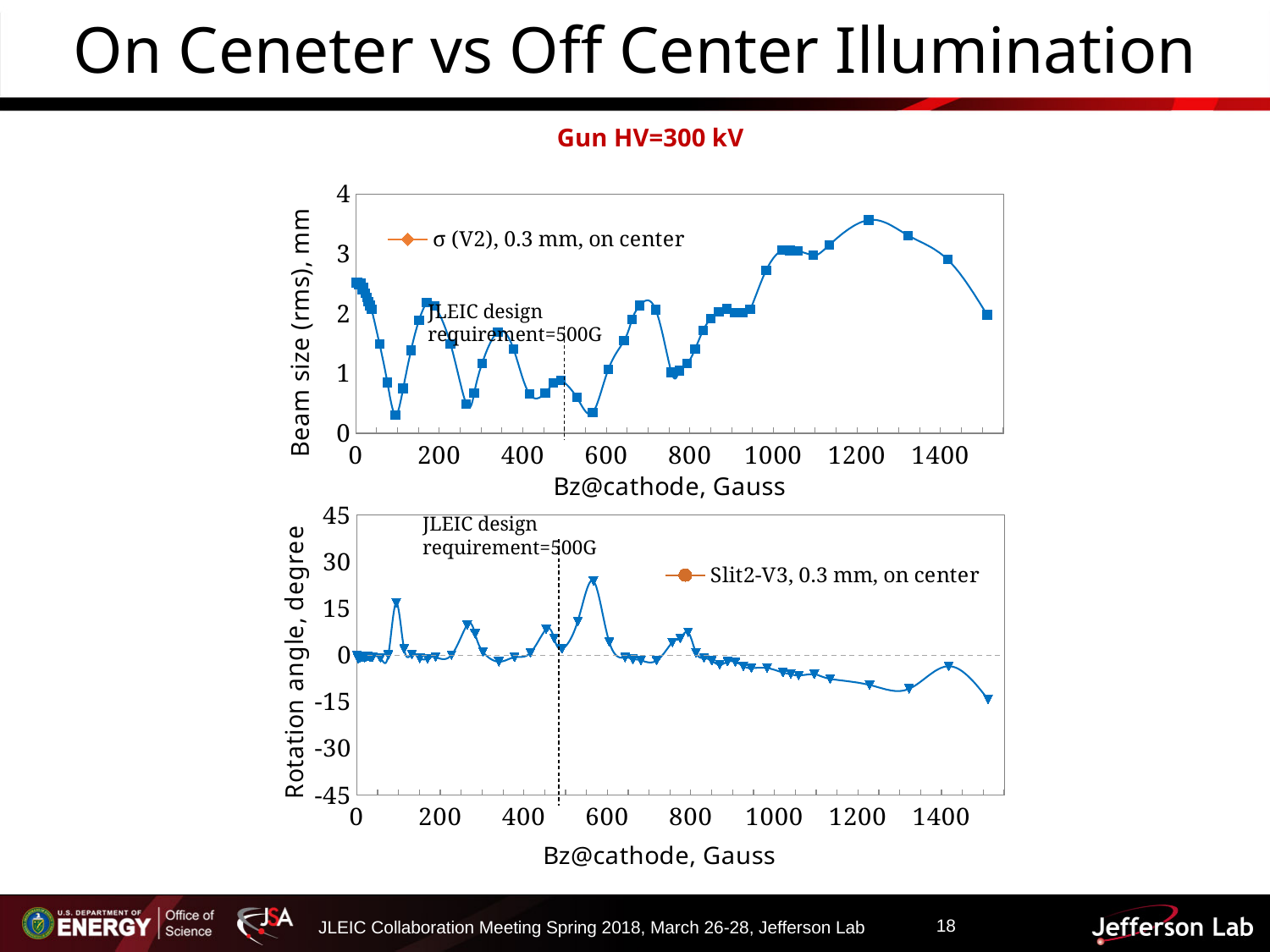
In the bottom chart, is the rotation angle at 1500 Gauss greater or less than 0 degrees? less What is the x-axis title of the top chart? Bz@cathode, Gauss In the top chart, is the beam size at 1000 Gauss greater or less than 2 mm? greater In the bottom chart, is the rotation angle at 1300 Gauss greater or less than 0 degrees? less What kind of chart is the bottom chart on the slide? line chart What kind of chart is the top chart on the slide? line chart What is the legend entry of the bottom chart? Slit2-V3, 0.3 mm, on center How many series does the legend of the top chart list? 1 How many series does the legend of the bottom chart list? 1